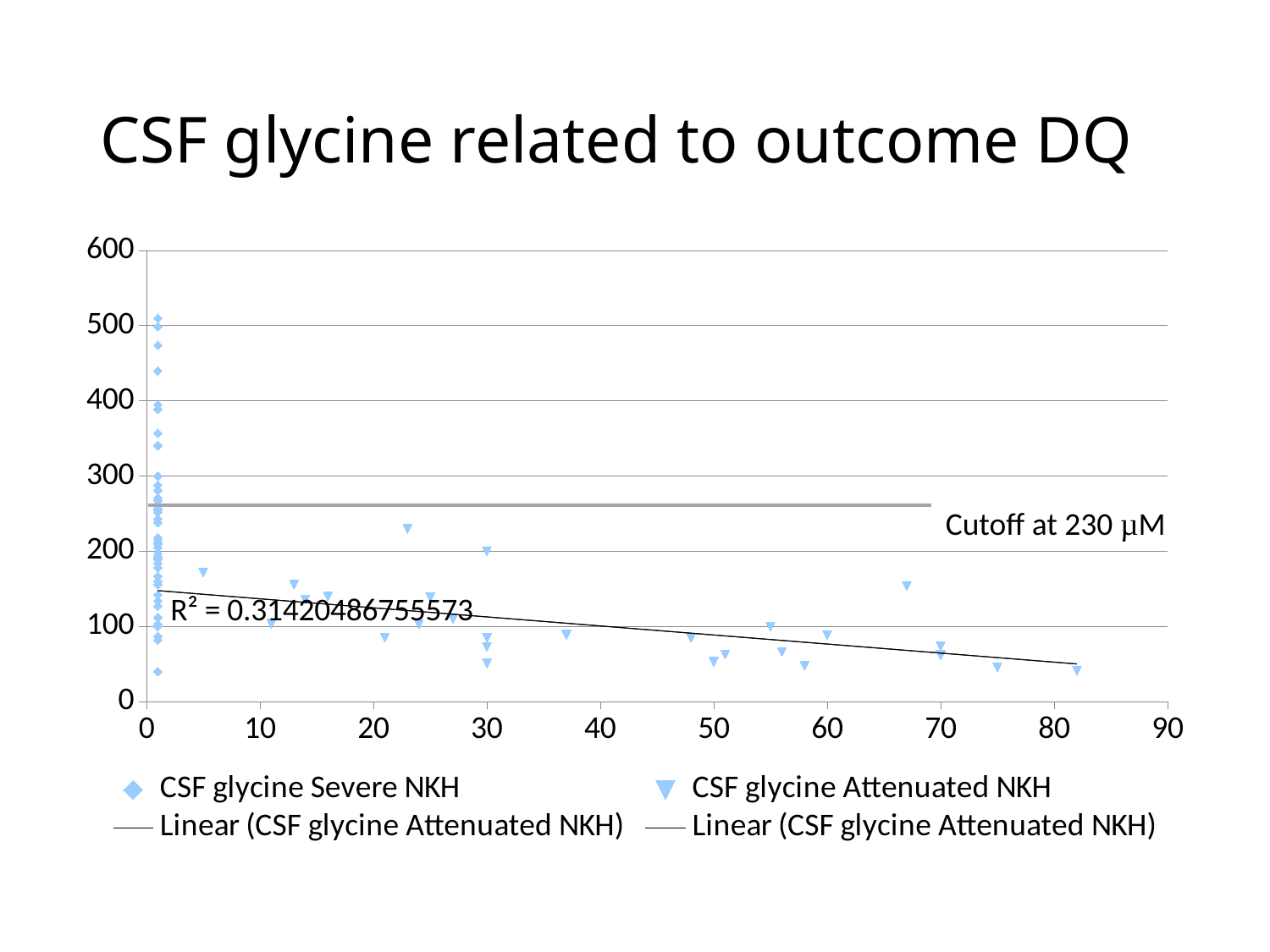
Is the CSF glycine Attenuated NKH value at x = 82 greater or less than 100? less What R² value is printed on the chart? R² = 0.314204867555573 Is the CSF glycine Attenuated NKH value at x = 67 greater or less than 100? greater What cutoff value is labelled next to the horizontal grey line on the chart? Cutoff at 230 µM Does the linear trend line for CSF glycine Attenuated NKH rise or fall as the x-axis value increases? fall Which series is plotted with diamond markers? CSF glycine Severe NKH What is the title of the chart? CSF glycine related to outcome DQ What is the maximum value shown on the y-axis? 600 What kind of chart is shown on the slide? scatter chart How many entries does the chart legend list? 4 Is the CSF glycine Attenuated NKH value at x = 23 greater or less than 200? greater